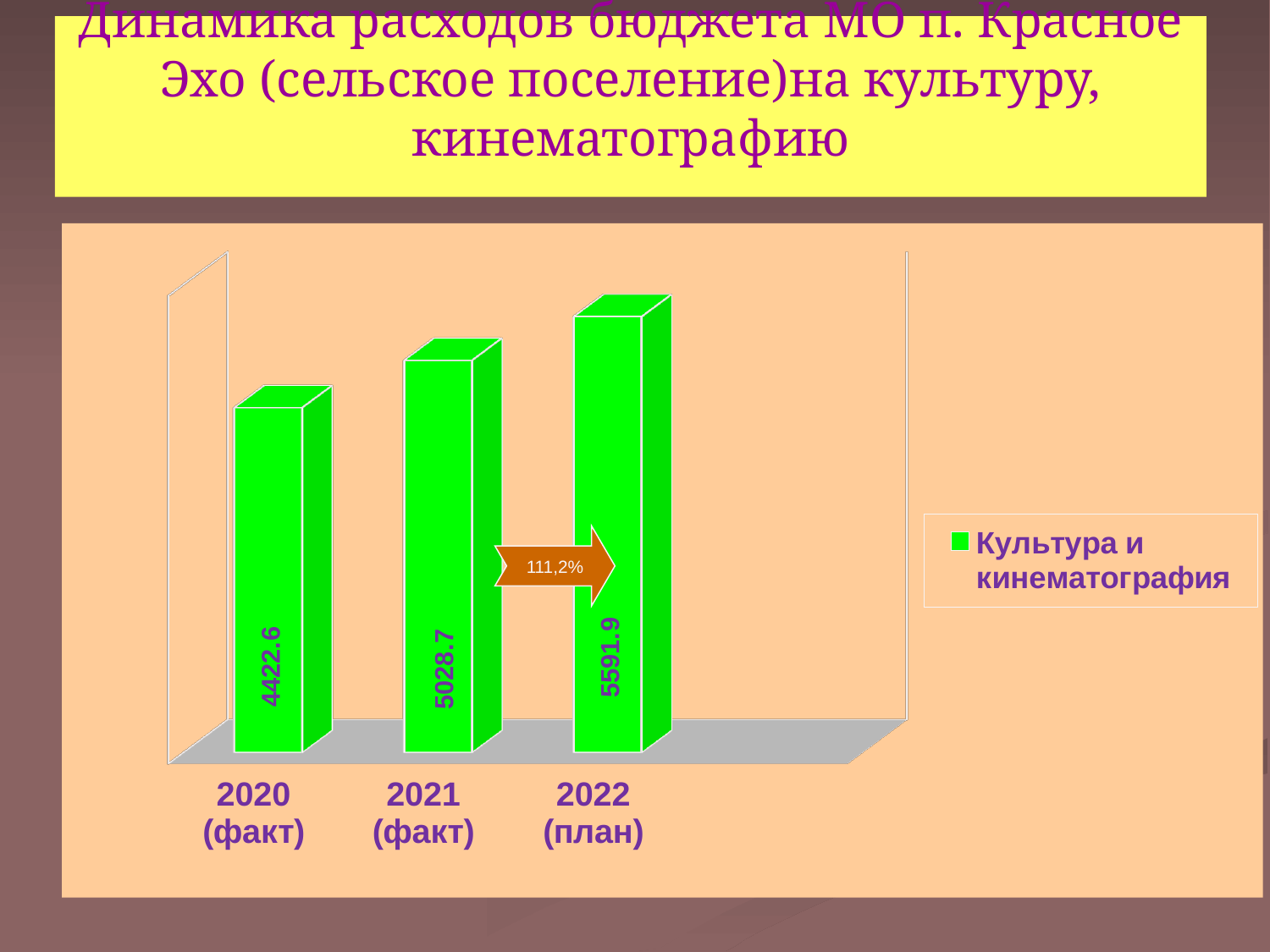
What is the value for 2021 (факт)? 5028.7 What is the difference between the values for 2021 (факт) and 2020 (факт)? 606.1 How many series does the legend list? 1 What is the difference between the values for 2022 (план) and 2021 (факт)? 563.2 What is the value for 2020 (факт)? 4422.6 Which year has the lowest value? 2020 (факт) Which is larger, the value for 2021 (факт) or the value for 2022 (план)? 2022 (план) What is the value for 2022 (план)? 5591.9 How many bars are shown in the chart? 3 What kind of chart is shown on the slide? Bar chart Which year has the highest value? 2022 (план) Do the values rise or fall from 2020 to 2022? Rise